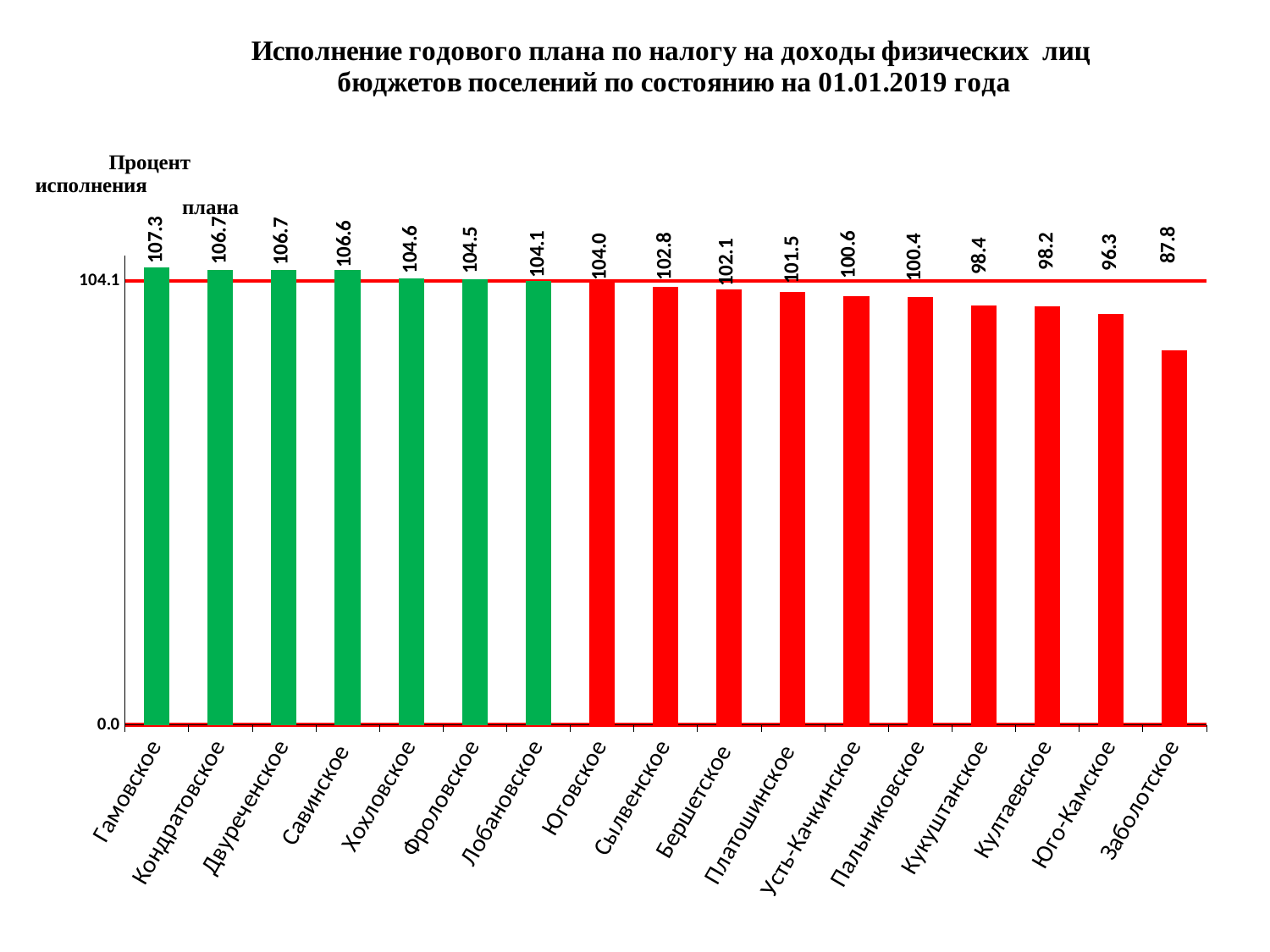
Do the values rise or fall from left to right along the x axis? fall Which is larger, the value for Хохловское or the value for Кукуштанское? Хохловское What is the value for Усть-Качкинское? 100.6 What kind of chart is this? bar chart Which category has the highest value? Гамовское What value does the horizontal red reference line mark on the y axis? 104.1 What is the difference between the values for Сылвенское and Бершетское? 0.7 What is the value for Гамовское? 107.3 Which category has the lowest value? Заболотское How many categories are shown on the x axis? 17 What is the value for Заболотское? 87.8 What is the difference between the values for Гамовское and Заболотское? 19.5